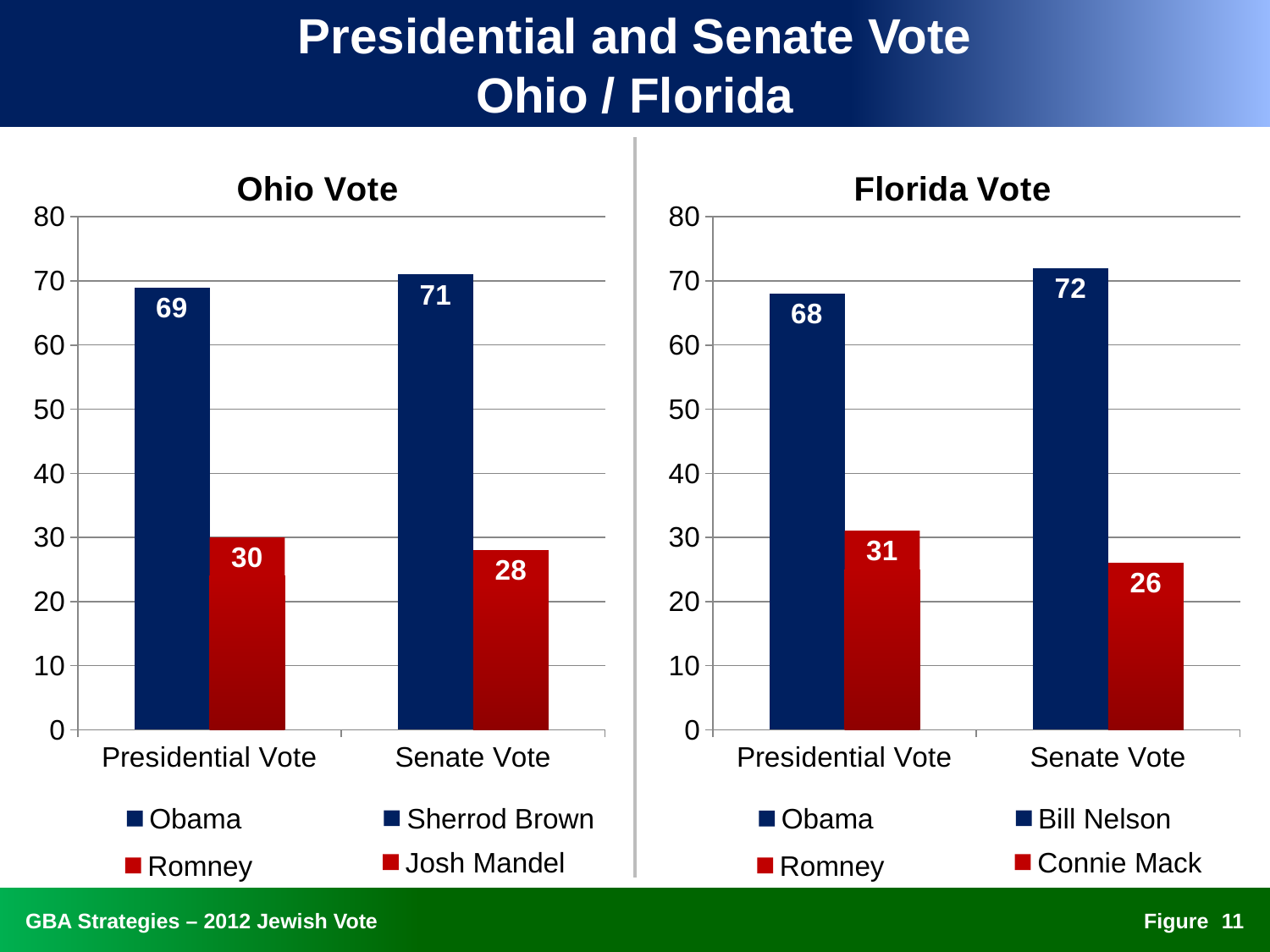
In the Ohio Vote chart, what value is shown for Obama in the Presidential Vote? 69 In the Florida Vote chart, what value is shown for Bill Nelson in the Senate Vote? 72 In the Ohio Vote chart, which bar has the highest value? Sherrod Brown In the Ohio Vote chart, which is larger: Romney's Presidential Vote value or Josh Mandel's Senate Vote value? Romney's Presidential Vote value How many series does the legend of the Florida Vote chart list? 4 In the Florida Vote chart, is the value for Obama greater or less than 60? greater In the Florida Vote chart, which bar has the lowest value? Connie Mack In the Ohio Vote chart, what is the difference between Obama's and Romney's Presidential Vote values? 39 In the Ohio Vote chart, what value is shown for Josh Mandel in the Senate Vote? 28 What type of chart is the Ohio Vote chart? Bar chart In the Florida Vote chart, what is the difference between Bill Nelson's and Connie Mack's Senate Vote values? 46 In the Florida Vote chart, what value is shown for Romney in the Presidential Vote? 31